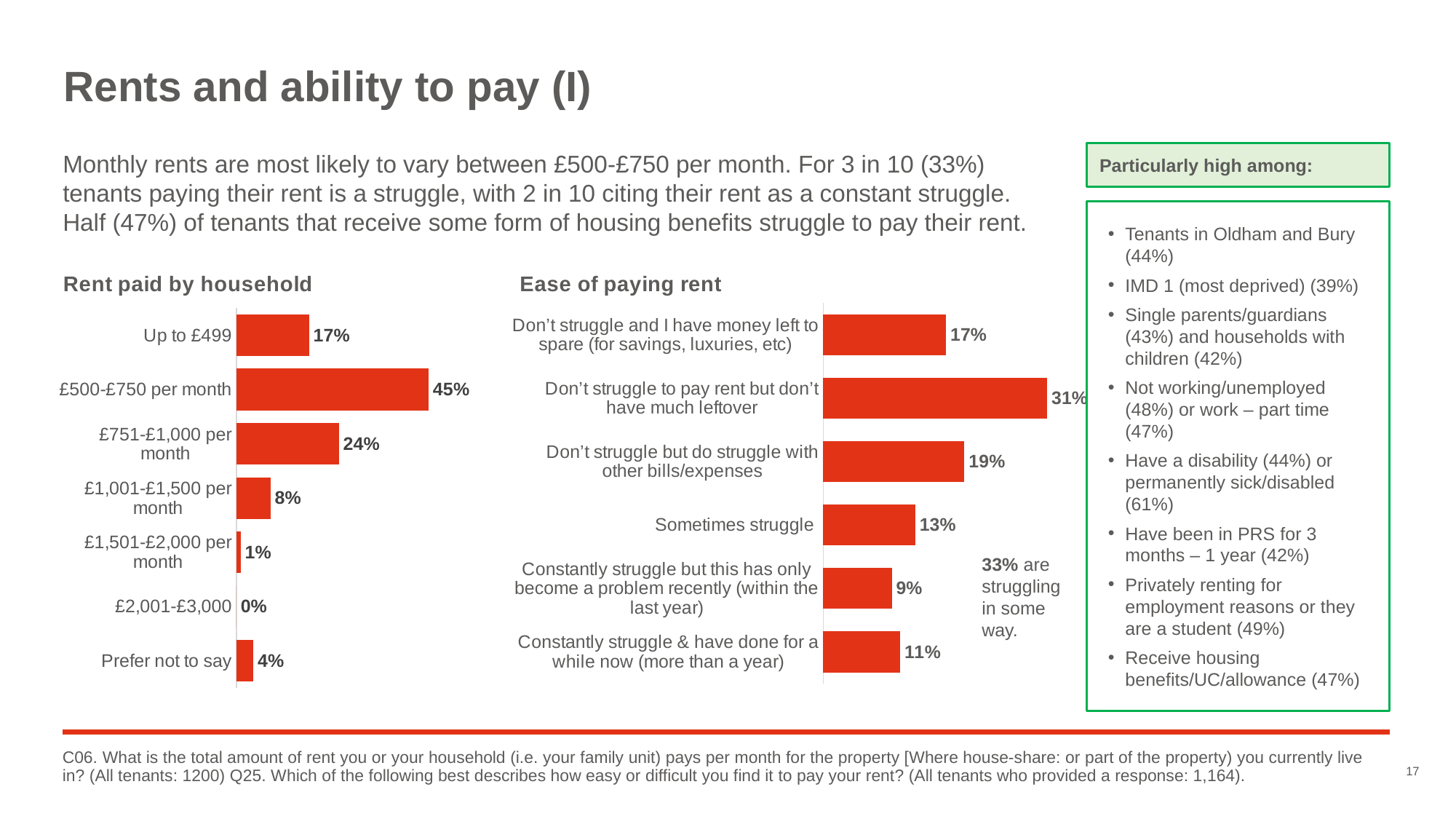
In the 'Ease of paying rent' chart, which is larger: 'Constantly struggle & have done for a while now (more than a year)' or 'Constantly struggle but this has only become a problem recently (within the last year)'? Constantly struggle & have done for a while now (more than a year) In the 'Ease of paying rent' chart, which response has the highest percentage? Don't struggle to pay rent but don't have much leftover In the 'Rent paid by household' chart, which category has a value of 0%? £2,001-£3,000 In the 'Ease of paying rent' chart, how many response categories are shown? 6 In the 'Rent paid by household' chart, what percentage of households pay £500-£750 per month? 45% In the 'Rent paid by household' chart, how many categories are shown? 7 In the 'Rent paid by household' chart, which rent band has the highest percentage? £500-£750 per month In the 'Ease of paying rent' chart, what is the difference between 'Don't struggle but do struggle with other bills/expenses' and 'Sometimes struggle'? 6% In the 'Ease of paying rent' chart, what percentage of tenants 'Sometimes struggle'? 13% In the 'Rent paid by household' chart, what is the value for £1,001-£1,500 per month? 8% In the 'Rent paid by household' chart, what is the difference between the £500-£750 per month and £751-£1,000 per month values? 21% What type of chart is the 'Ease of paying rent' chart? Bar chart